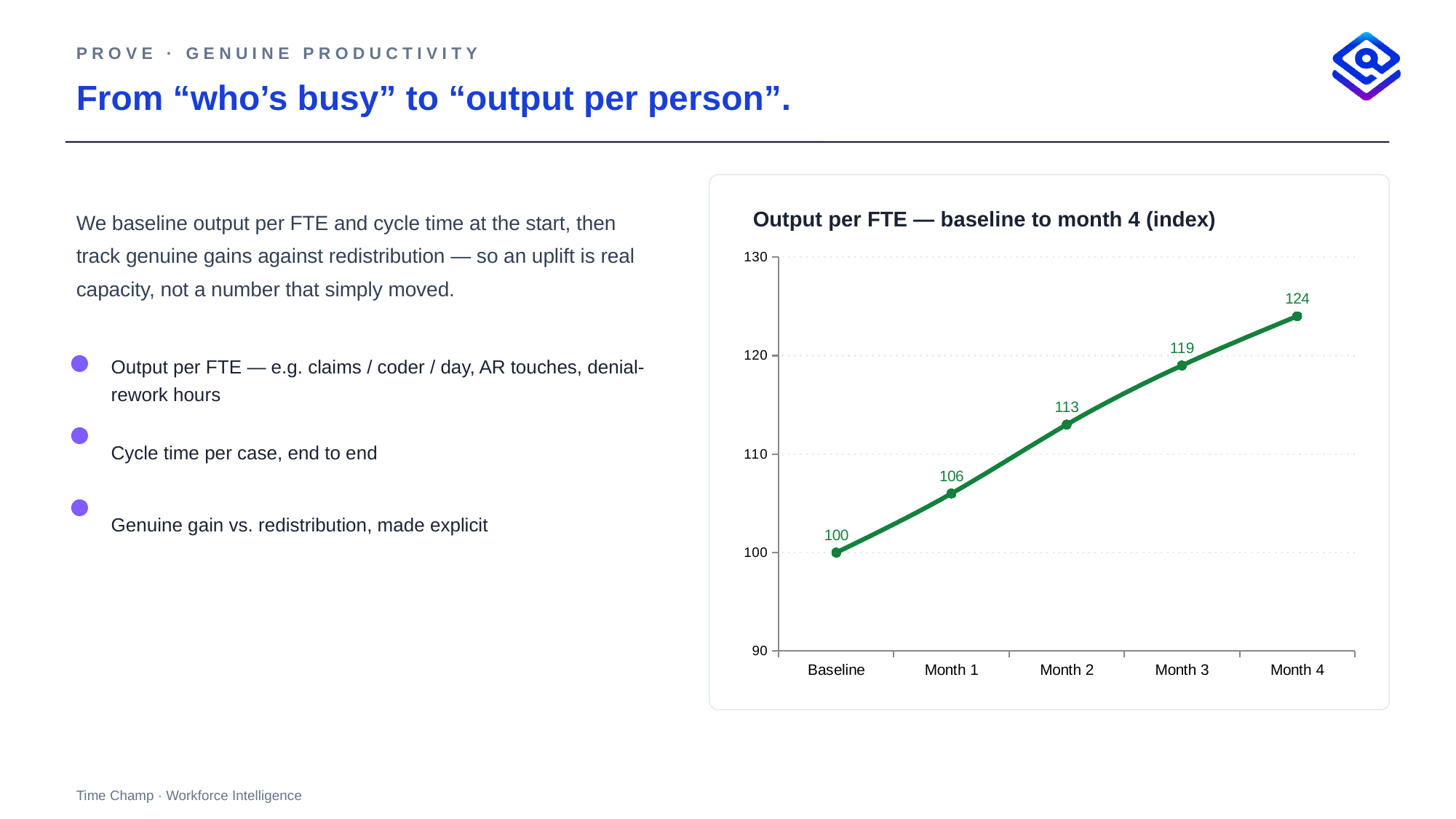
Which point has the highest value? Month 4 What is the difference between the Month 4 value and the Baseline value? 24 What is the value for Month 4? 124 How many data points are plotted on the chart? 5 Do the values rise or fall from Baseline to Month 4? Rise Which point has the lowest value? Baseline Is the value for Month 2 greater or less than 110? greater What is the value at Baseline? 100 What is the difference between Month 3 and Month 1? 13 What is the value for Month 2? 113 Which is larger, the value for Month 1 or the value for Month 3? Month 3 What kind of chart is shown? Line chart